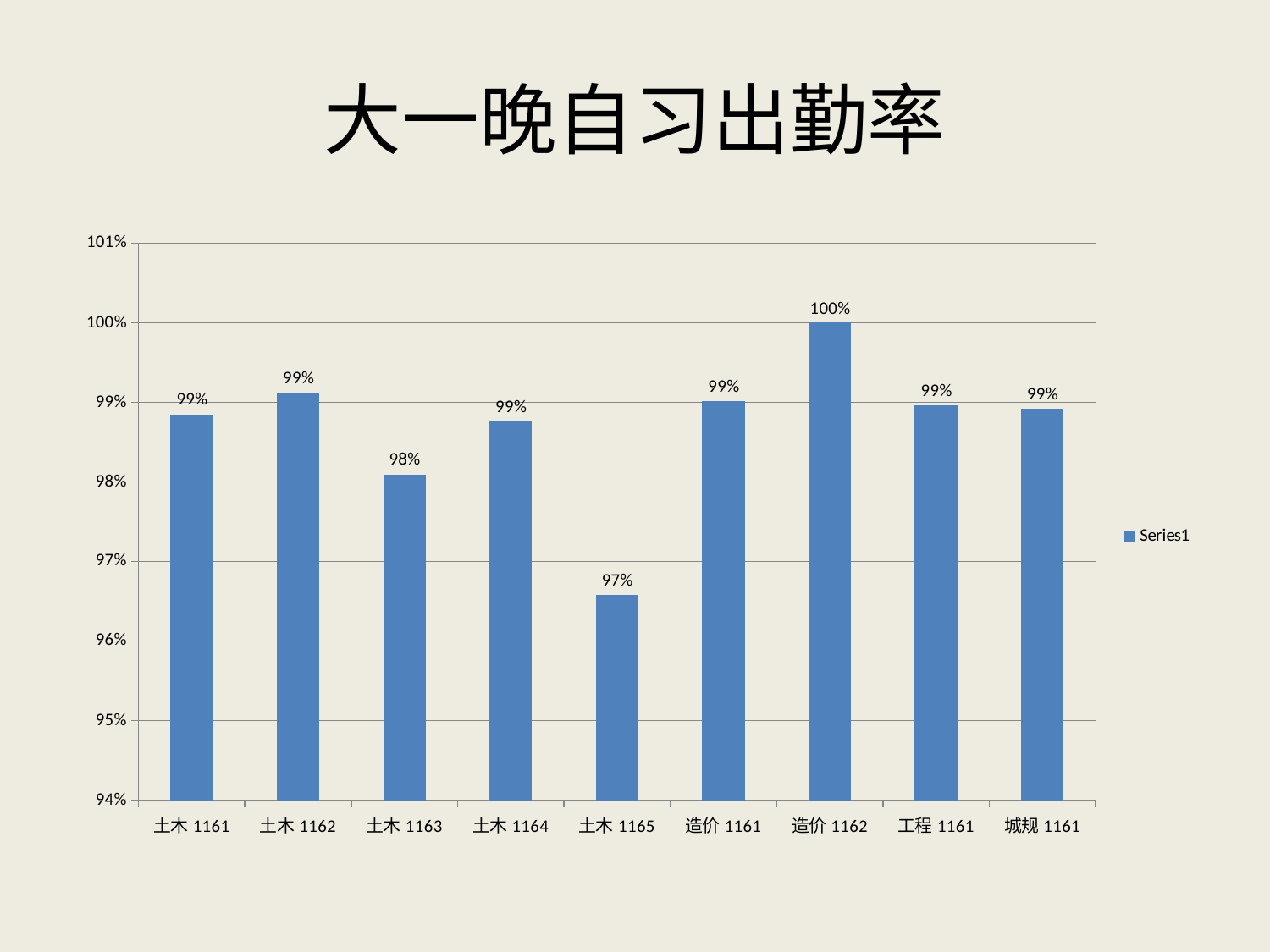
Which category has the highest value? 造价 1162 What is the value for 土木 1165? 97% What is the value for 土木 1163? 98% Which is larger, the value for 土木 1163 or the value for 土木 1165? 土木 1163 What is the difference between the values for 造价 1162 and 土木 1165? 3% What kind of chart is shown on the slide? bar chart Which category has the lowest value? 土木 1165 What is the value for 造价 1162? 100% How many categories are shown on the x axis? 9 How many series does the legend list? 1 What is the value for 工程 1161? 99%